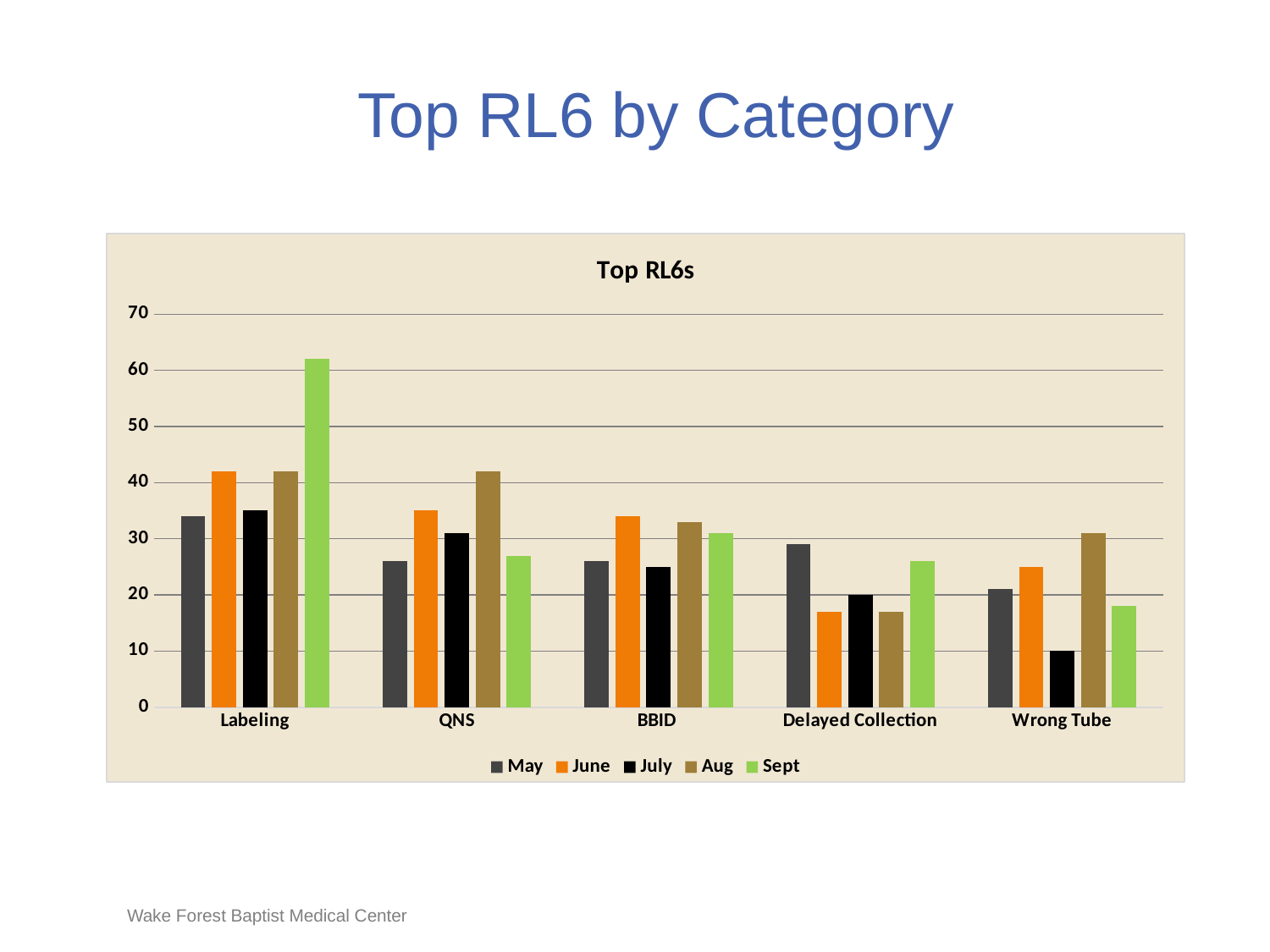
Which month has the highest value for QNS? Aug Is the value for June in Delayed Collection greater or less than 20? less Which is larger for Labeling, the May value or the Sept value? Sept Which month has the highest value for Wrong Tube? Aug How many categories are shown on the x axis? 5 Is the value for Sept in Labeling greater or less than 60? greater How many series does the legend list? 5 Which month has the highest value for Labeling? Sept Which month has the lowest value for Wrong Tube? July What is the title of the chart? Top RL6s What kind of chart is shown on the slide? bar chart